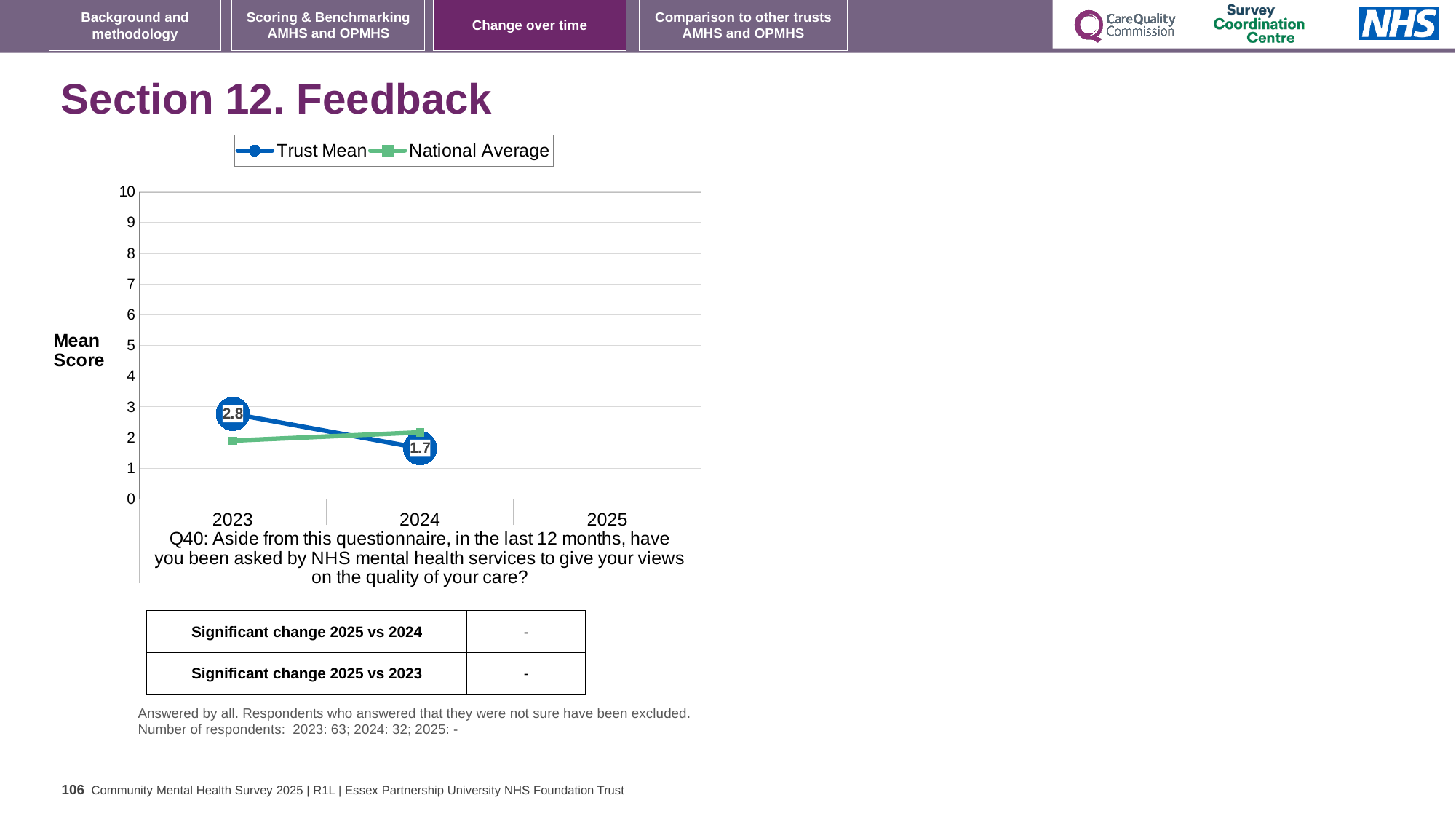
How many series does the legend list? 2 What kind of chart is shown on the slide? line chart How many years are shown on the x axis? 3 Does the Trust Mean rise or fall from 2023 to 2024? fall In 2023, which is larger: the Trust Mean or the National Average? Trust Mean Is the National Average value for 2023 greater or less than 3? less In 2024, which is larger: the Trust Mean or the National Average? National Average What is the label on the y axis of the chart? Mean Score What is the Trust Mean value for 2024? 1.7 In which year is the Trust Mean highest? 2023 What is the Trust Mean value for 2023? 2.8 By how much did the Trust Mean fall from 2023 to 2024? 1.1